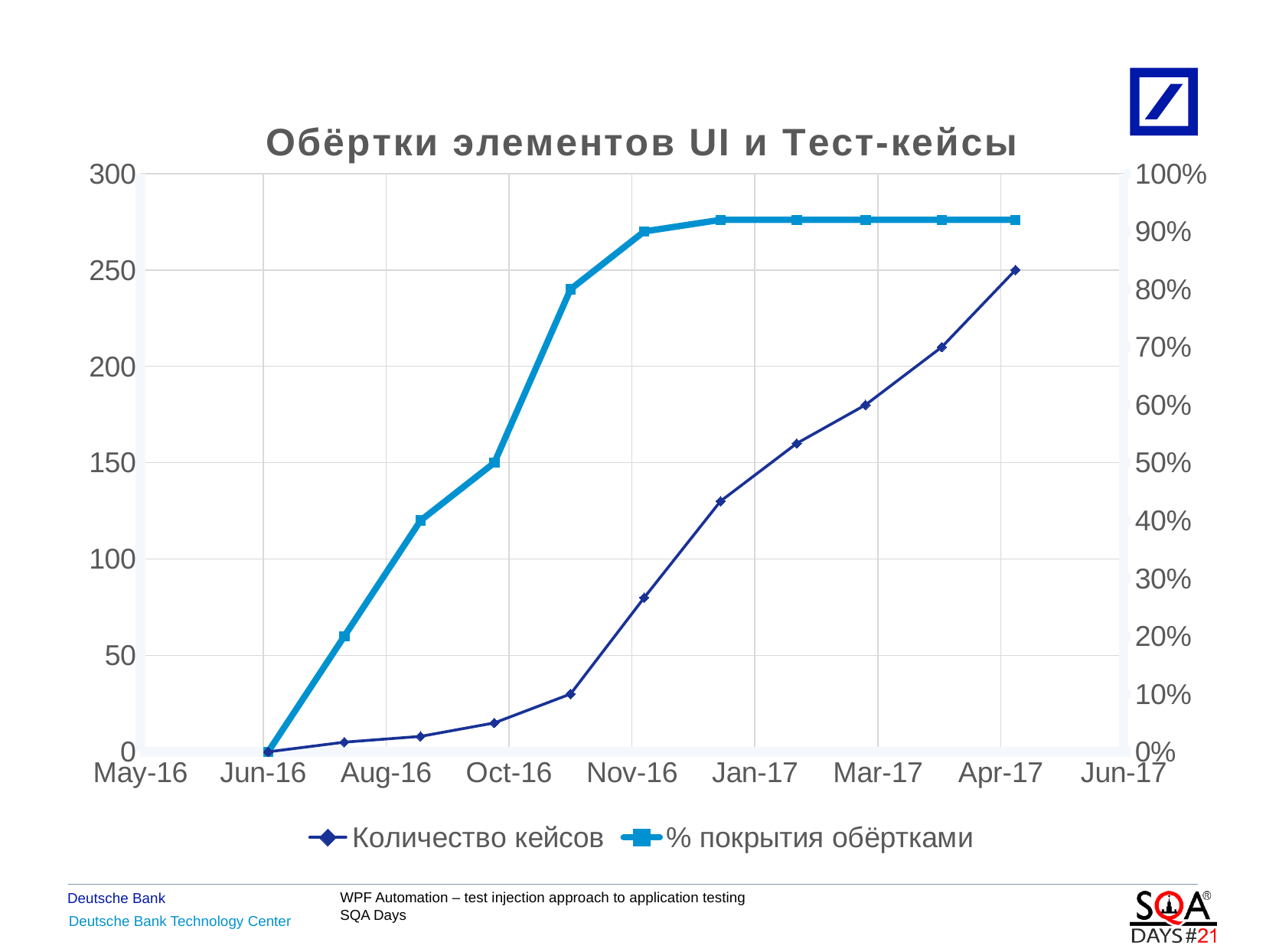
How many series does the legend list? 2 Is the value of "% покрытия обёртками" at Jan-17 greater or less than 80%? greater Is the value of "Количество кейсов" at Oct-16 greater or less than 50? less Which series is plotted with the thick light-blue line with square markers? % покрытия обёртками What is the title of the chart? Обёртки элементов UI и Тест-кейсы Does the "Количество кейсов" series rise or fall from Jun-16 to Apr-17? rise What kind of chart is shown on the slide? line chart Is the value of "Количество кейсов" at Jan-17 greater or less than 100? greater What is the value of "% покрытия обёртками" at Oct-16? 50%